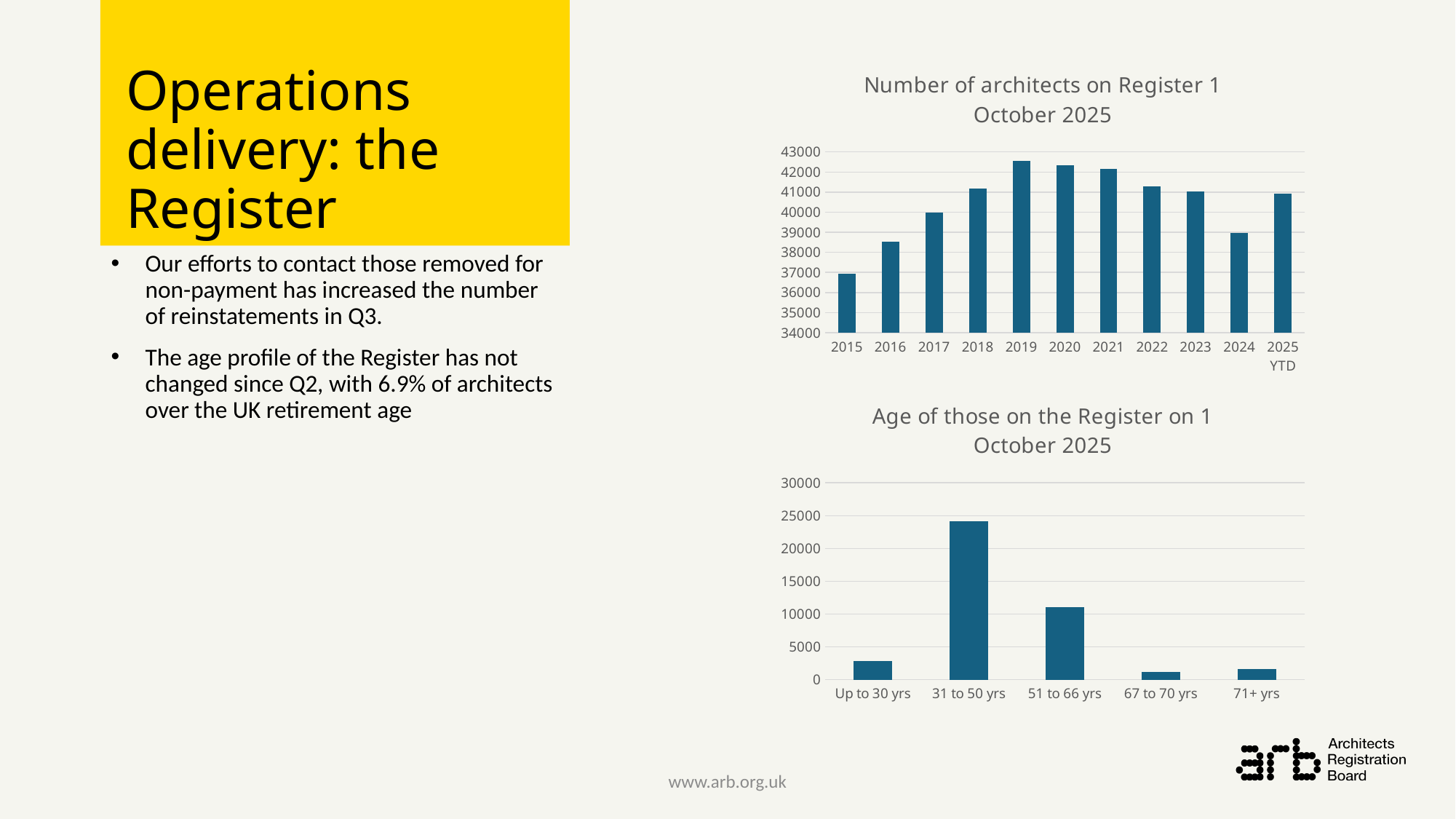
In the top chart, 'Number of architects on Register 1 October 2025', which is larger, the value for 2018 or the value for 2024? 2018 In the top chart, 'Number of architects on Register 1 October 2025', which year has the lowest number of architects? 2015 In the top chart, 'Number of architects on Register 1 October 2025', is the value for 2024 greater or less than 40000? less In the top chart, 'Number of architects on Register 1 October 2025', is the value for 2016 greater or less than 38000? greater In the bottom chart, 'Age of those on the Register on 1 October 2025', which age group has the highest number? 31 to 50 yrs In the top chart, 'Number of architects on Register 1 October 2025', which year has the highest number of architects? 2019 In the bottom chart, 'Age of those on the Register on 1 October 2025', is the value for 31 to 50 yrs greater or less than 20000? greater In the bottom chart, 'Age of those on the Register on 1 October 2025', which age group has the lowest number? 67 to 70 yrs What kind of chart is the bottom chart, 'Age of those on the Register on 1 October 2025'? bar chart In the top chart, 'Number of architects on Register 1 October 2025', how many years are shown on the x axis? 11 In the bottom chart, 'Age of those on the Register on 1 October 2025', how many age groups are shown? 5